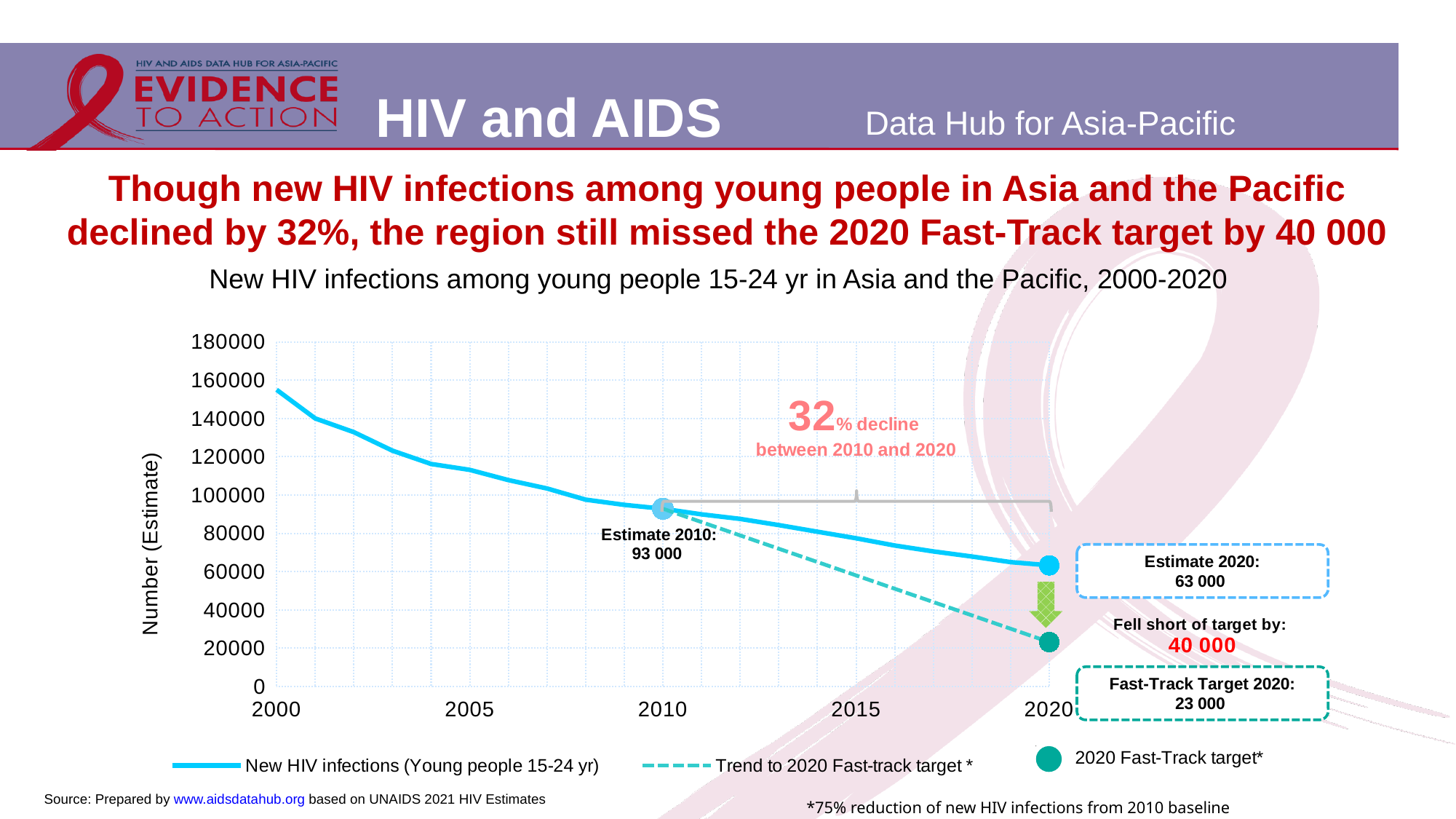
Is the value for new HIV infections in 2005 greater or less than 120000? less By how much did the 2020 estimate fall short of the Fast-Track target? 40 000 What is the difference between the 2010 estimate and the 2020 estimate of new HIV infections? 30 000 Which is larger, the 2020 estimate of new HIV infections or the 2020 Fast-Track target? 2020 estimate Do new HIV infections among young people rise or fall from 2000 to 2020? Fall What is the estimated number of new HIV infections among young people in 2010? 93 000 What percentage decline in new HIV infections is shown between 2010 and 2020? 32% What is the estimated number of new HIV infections among young people in 2020? 63 000 Is the value for new HIV infections in 2000 greater or less than 140000? greater What is the 2020 Fast-Track target value shown on the chart? 23 000 How many entries does the chart legend list? 3 What kind of chart is shown on the slide? Line chart